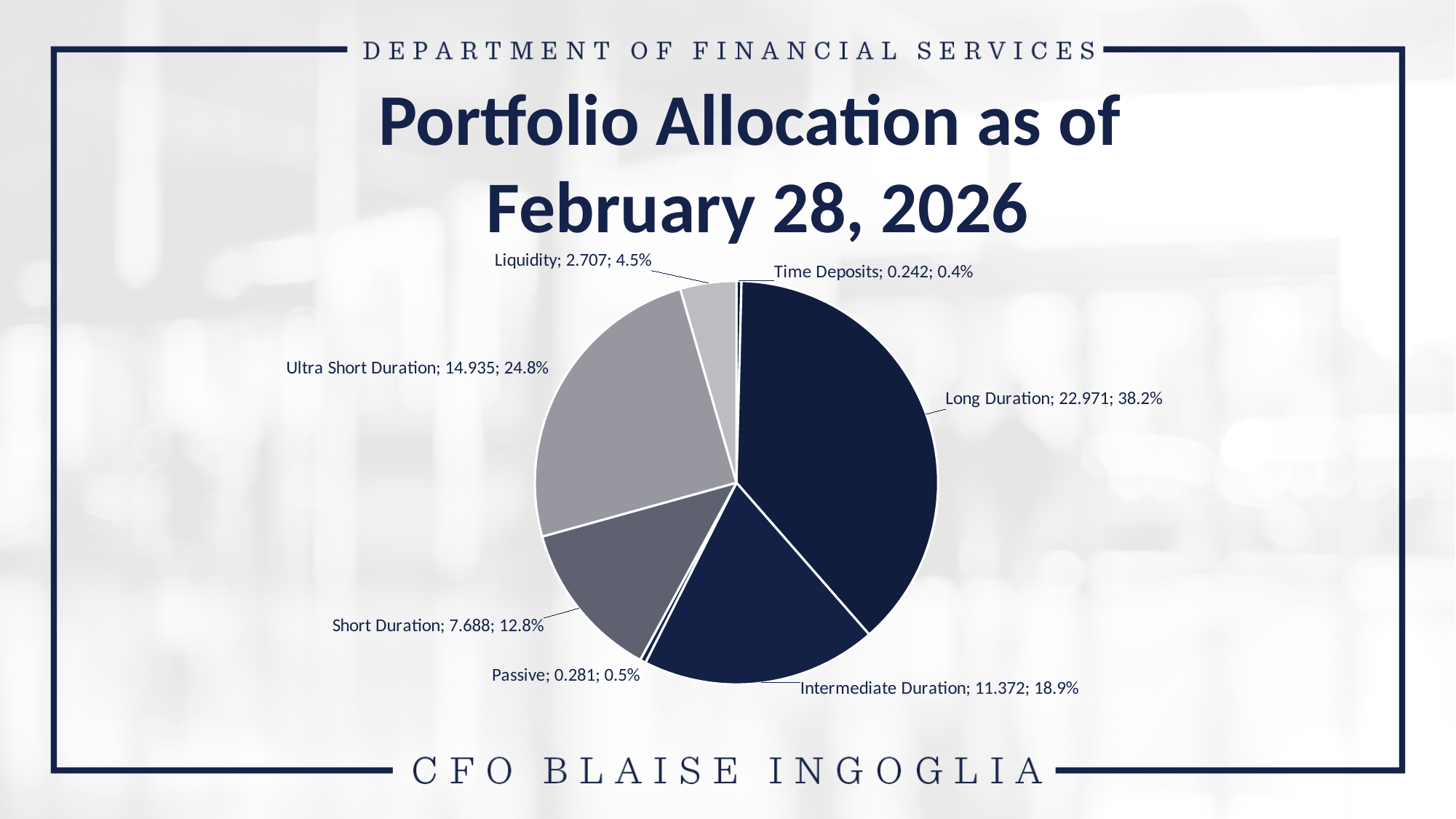
What is the value for Intermediate Duration? 11.372 Which category has the smallest slice? Time Deposits What is the title of the chart? Portfolio Allocation as of February 28, 2026 How many categories are shown in the pie chart? 7 What share of the pie does Liquidity represent? 4.5% What is the value for Long Duration? 22.971 Which is larger, Short Duration or Intermediate Duration? Intermediate Duration What is the value for Passive? 0.281 What kind of chart is shown on the slide? Pie chart Which category has the largest slice? Long Duration What is the difference between the values for Long Duration and Ultra Short Duration? 8.036 What share of the pie does Ultra Short Duration represent? 24.8%